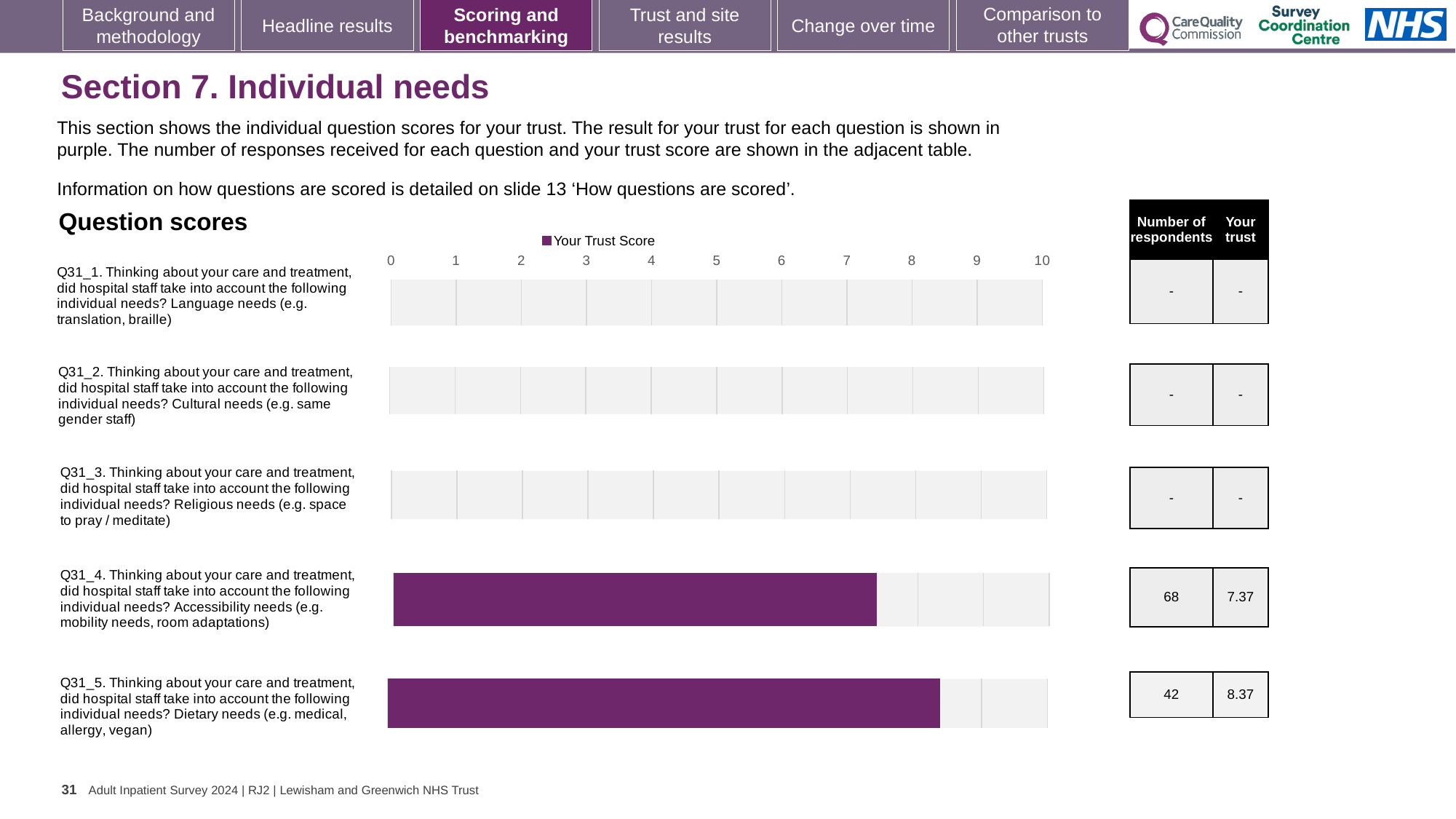
Is the trust score for Q31_4 (Accessibility needs) greater or less than 8? less How many respondents answered Q31_4 (Accessibility needs)? 68 Which has a higher trust score, Q31_4 (Accessibility needs) or Q31_5 (Dietary needs)? Q31_5 (Dietary needs) What is the trust score for Q31_5 (Dietary needs)? 8.37 What is the trust score for Q31_4 (Accessibility needs)? 7.37 What is the maximum value shown on the chart's axis? 10 How many questions are listed on the chart? 5 Which question has the highest trust score shown on the chart? Q31_5 (Dietary needs) What kind of chart is shown on the slide? Bar chart What is the difference between the trust scores for Q31_5 and Q31_4? 1 How many respondents answered Q31_5 (Dietary needs)? 42 How many series does the chart legend list? 1